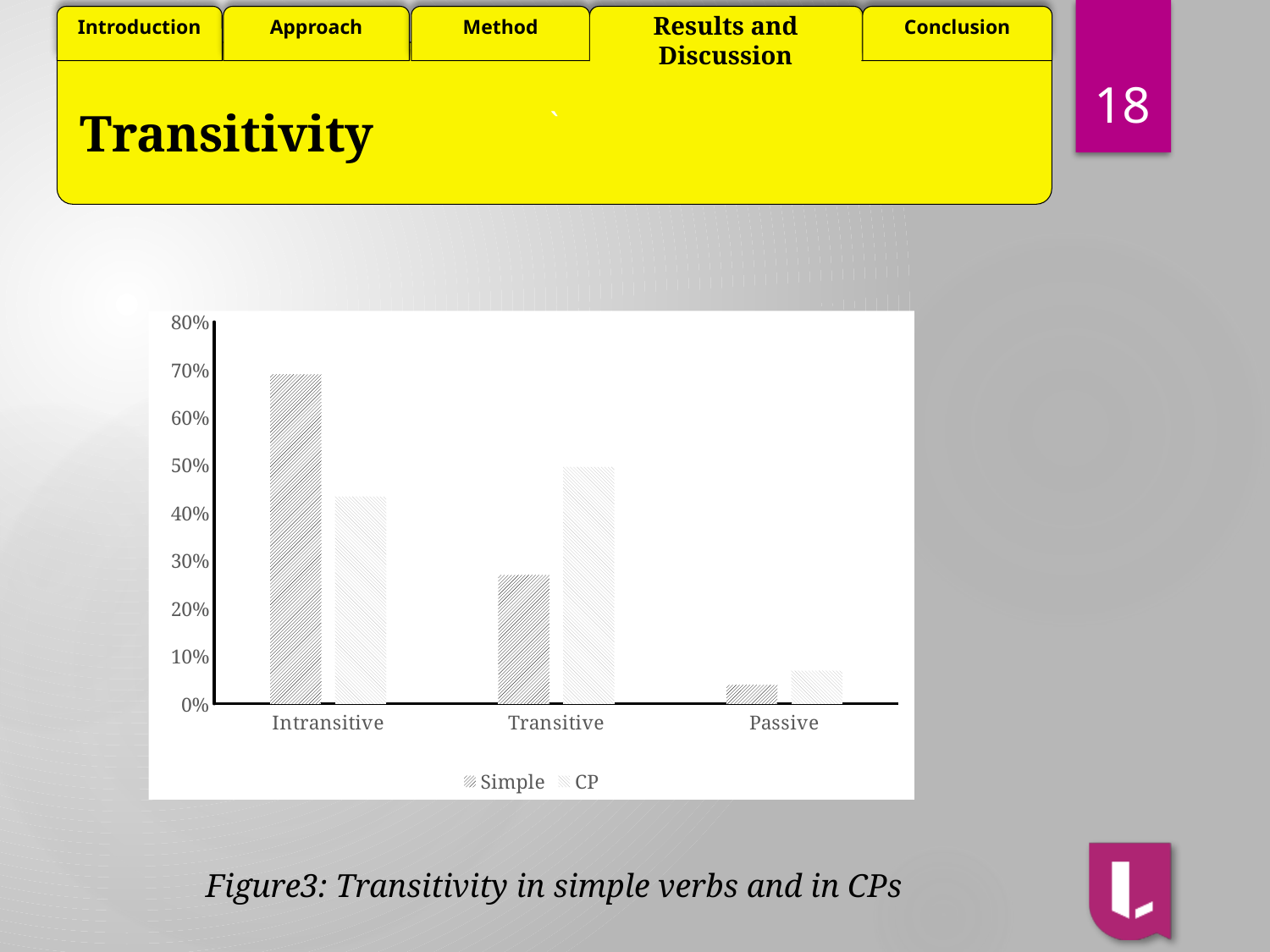
How many categories are shown on the x axis of the chart? 3 Which category has the lowest value for the CP series? Passive In the Transitive category, which series has the larger value, Simple or CP? CP Is the value for CP in the Intransitive category greater or less than 50%? less Which category has the highest value for the CP series? Transitive What kind of chart is shown on the slide? bar chart Is the value for CP in the Passive category greater or less than 10%? less What are the two series named in the chart's legend? Simple and CP Which category has the highest value for the Simple series? Intransitive Is the value for Simple in the Intransitive category greater or less than 60%? greater How many series does the chart's legend list? 2